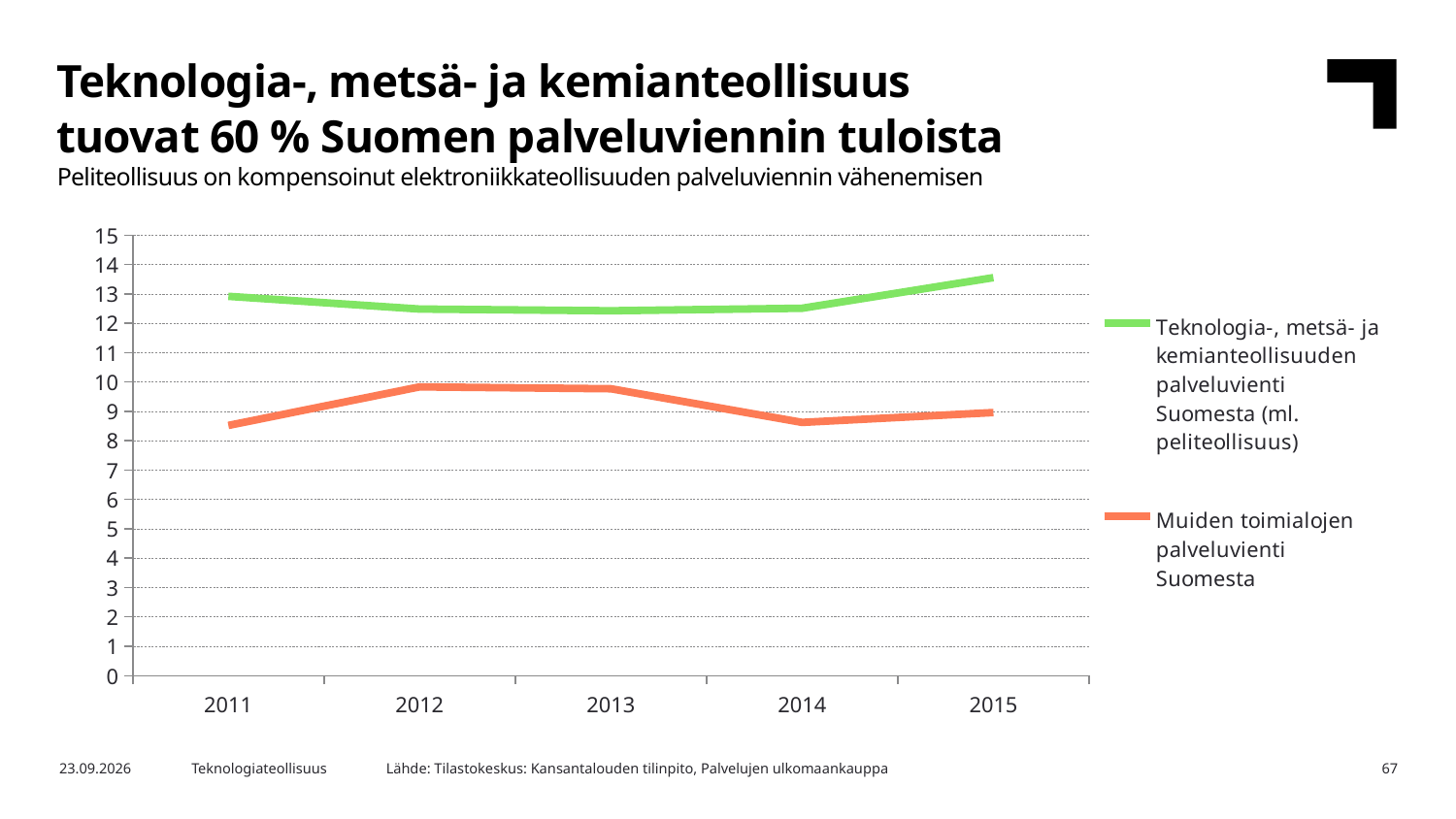
How many series does the legend list? 2 What colour is the line for Muiden toimialojen palveluvienti Suomesta? orange Which series has the larger value in 2013, Teknologia-, metsä- ja kemianteollisuuden palveluvienti Suomesta (ml. peliteollisuus) or Muiden toimialojen palveluvienti Suomesta? Teknologia-, metsä- ja kemianteollisuuden palveluvienti Suomesta (ml. peliteollisuus) Is the value for Teknologia-, metsä- ja kemianteollisuuden palveluvienti Suomesta (ml. peliteollisuus) in 2013 greater or less than 13? less Is the value for Muiden toimialojen palveluvienti Suomesta in 2012 greater or less than 10? less Does the value for Teknologia-, metsä- ja kemianteollisuuden palveluvienti Suomesta (ml. peliteollisuus) rise or fall from 2014 to 2015? rise In which year is the value for Teknologia-, metsä- ja kemianteollisuuden palveluvienti Suomesta (ml. peliteollisuus) highest? 2015 Is the value for Muiden toimialojen palveluvienti Suomesta in 2011 greater or less than 8? greater Does the value for Muiden toimialojen palveluvienti Suomesta rise or fall from 2011 to 2012? rise What kind of chart is shown on the slide? line chart How many years are shown on the x axis? 5